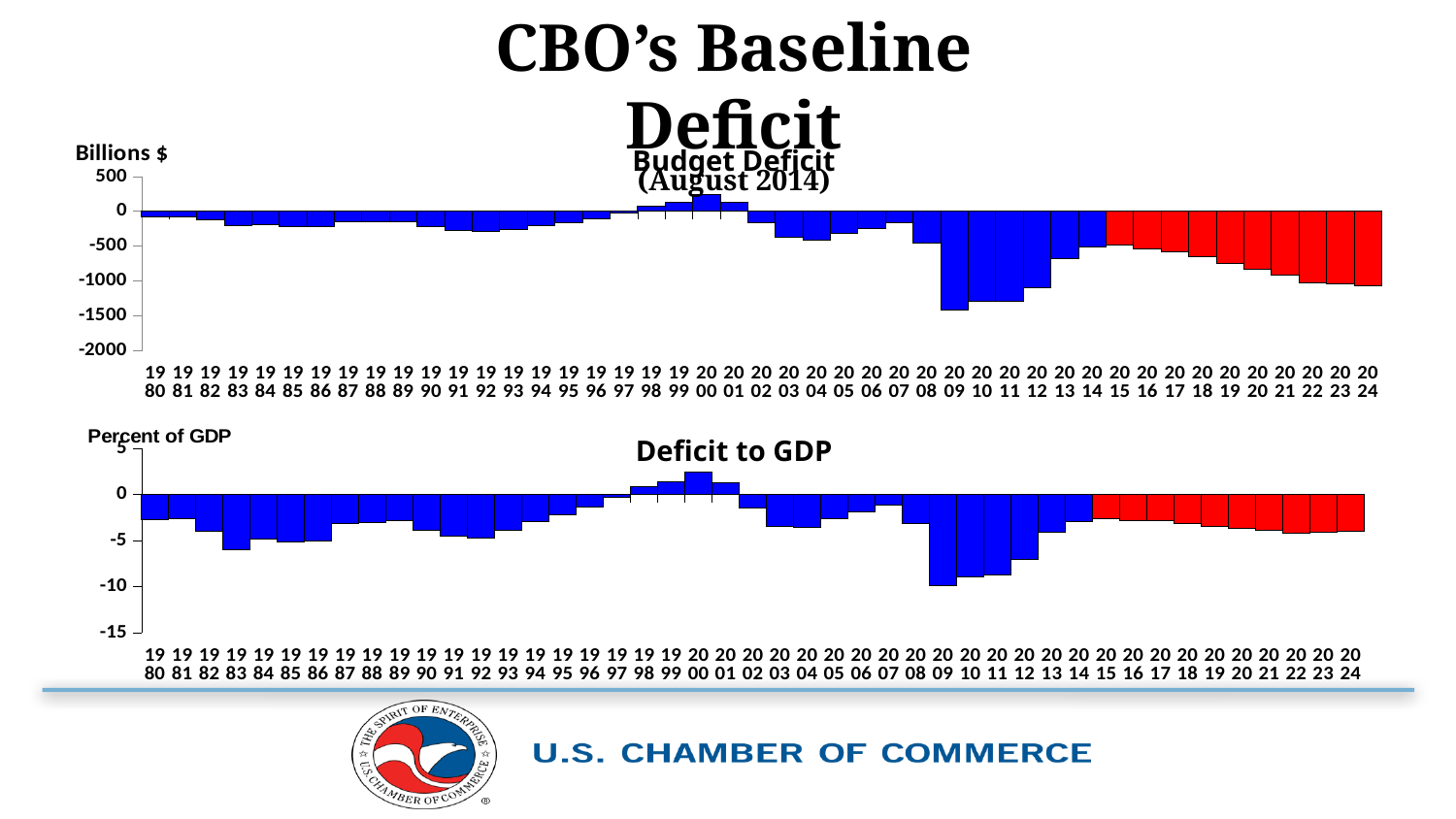
In the Budget Deficit chart, is the value for 2009 greater or less than -1000? less In the Budget Deficit chart, which year has the highest value? 2000 In the Deficit to GDP chart, is the value for 2000 greater or less than 0? greater In the Deficit to GDP chart, is the value for 1983 greater or less than -5? less How many years are shown on the x axis of the Deficit to GDP chart? 45 In the Budget Deficit chart, which is larger, the value for 2009 or the value for 2024? 2024 In the Budget Deficit chart, which year has the lowest value? 2009 In the Deficit to GDP chart, which year has the lowest value? 2009 What is the y-axis label of the Deficit to GDP chart? Percent of GDP What kind of chart is the Budget Deficit chart? bar chart In the Budget Deficit chart, do the values rise or fall from 2015 to 2024? fall